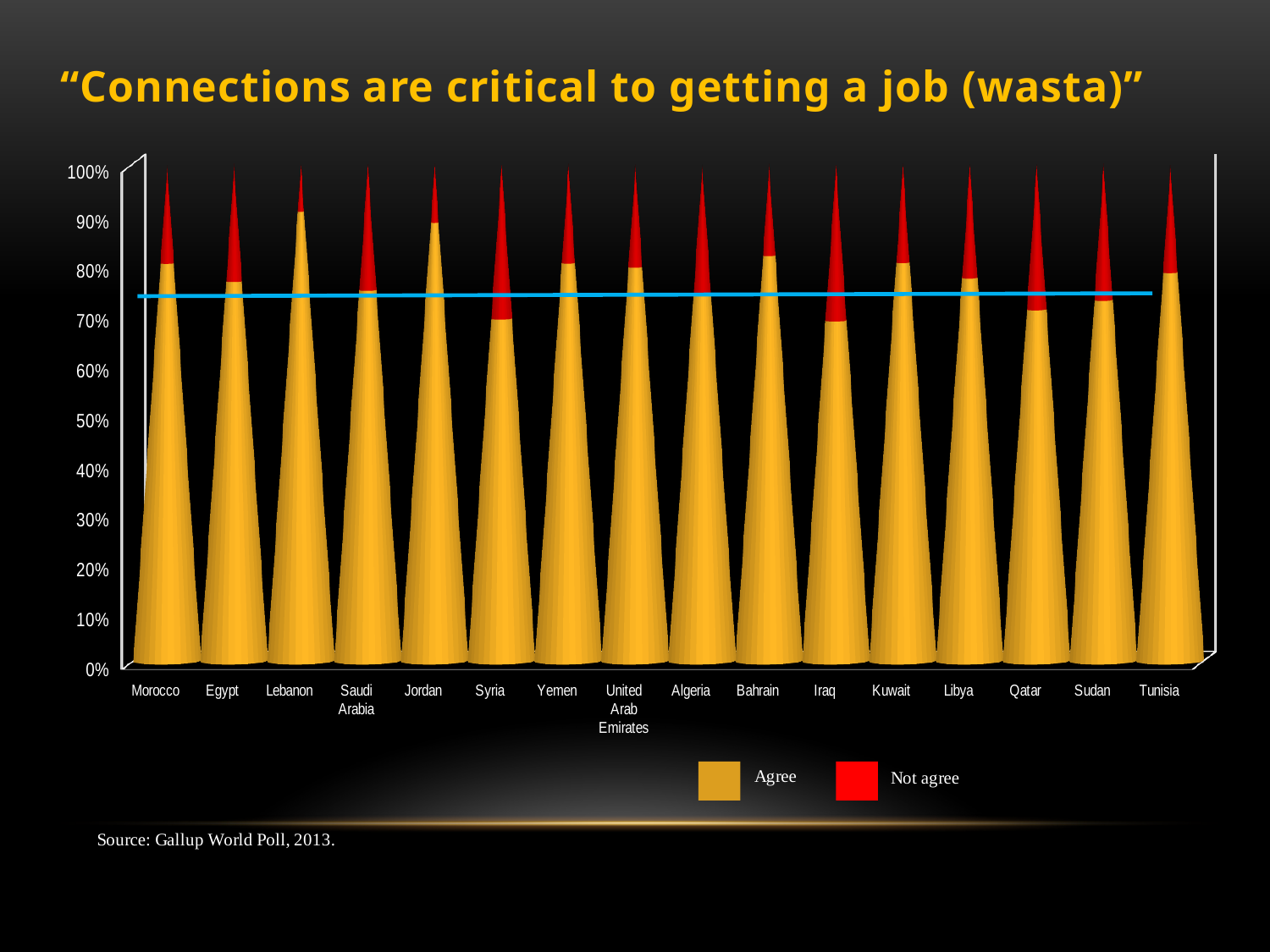
How many countries are shown along the x axis of the chart? 16 Is the Agree value for Bahrain greater or less than 80%? greater Which country has the larger Agree value, Lebanon or Syria? Lebanon Is the Agree value for Sudan greater or less than 80%? less Is the Agree value for Qatar greater or less than 80%? less How many series does the chart's legend list? 2 What are the two series named in the legend? Agree and Not agree What kind of chart is shown on the slide? bar chart Which country has the larger Agree value, Jordan or Qatar? Jordan What is the title of the chart on the slide? "Connections are critical to getting a job (wasta)"